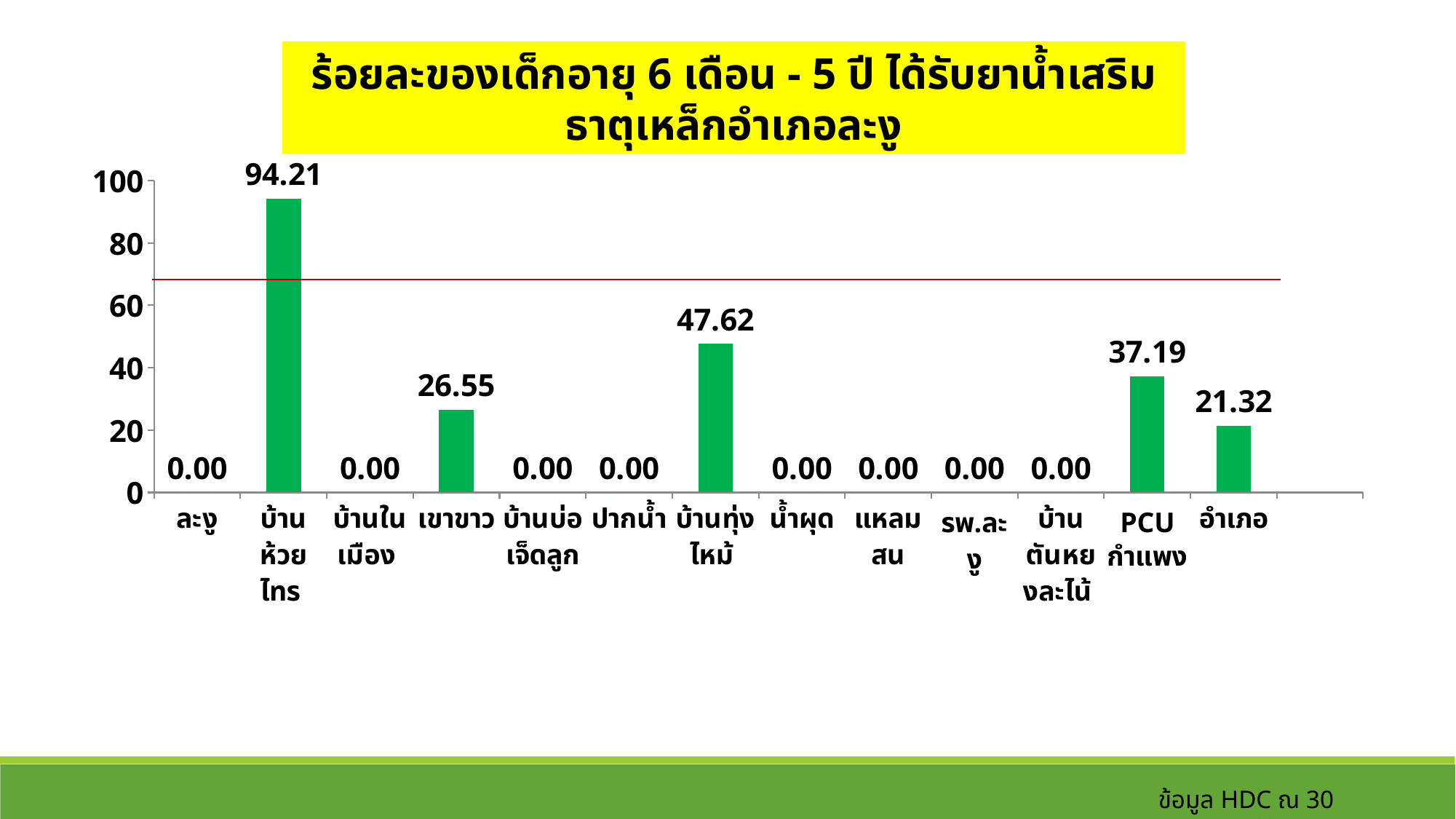
What colour are the bars in the chart? green What is the value for PCU กำแพง? 37.19 Which category has the highest value? บ้านห้วยไทร What is the value for อำเภอ? 21.32 What is the difference between the values for บ้านห้วยไทร and บ้านทุ่งไหม้? 46.59 How many categories have a value of 0.00? 8 What type of chart is shown on the slide? bar chart What is the value for บ้านห้วยไทร? 94.21 How many categories are shown on the x axis? 13 What is the value for บ้านทุ่งไหม้? 47.62 Which is larger, the value for PCU กำแพง or the value for เขาขาว? PCU กำแพง What is the value for เขาขาว? 26.55